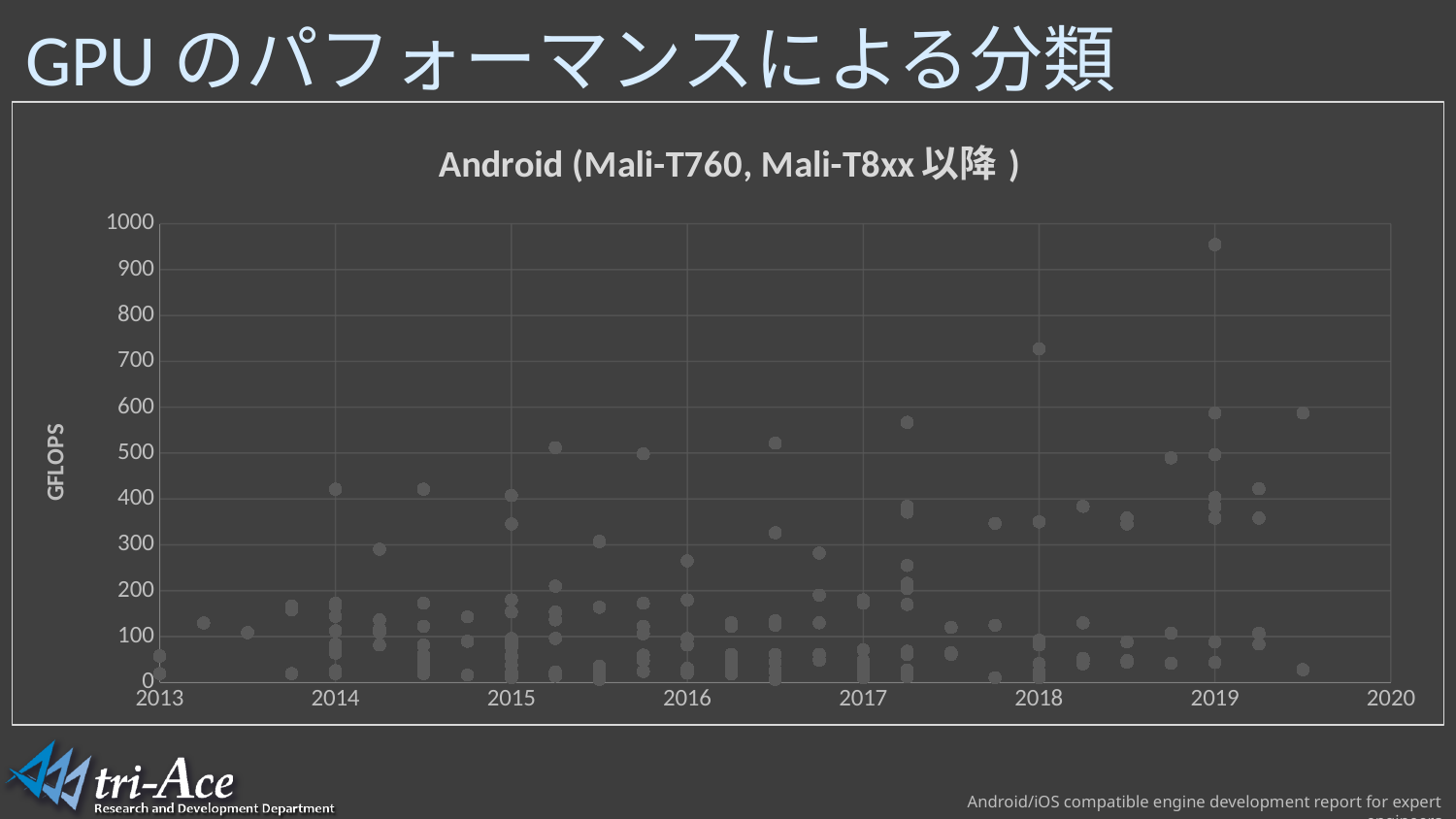
Is the highest point plotted near 2014 greater or less than 400 GFLOPS? greater What is the highest value shown on the vertical axis? 1000 Around which year does the highest point on the chart appear? 2019 What is the first year shown on the horizontal axis? 2013 Do the maximum GFLOPS values generally rise or fall from 2013 to 2019? rise Is the highest point plotted near 2018 greater or less than 700 GFLOPS? greater What is the title of the chart? Android (Mali-T760, Mali-T8xx 以降） What kind of chart is shown on the slide? Scatter chart What is the label of the vertical axis? GFLOPS Is the highest point plotted near 2019 greater or less than 900 GFLOPS? greater What is the last year shown on the horizontal axis? 2020